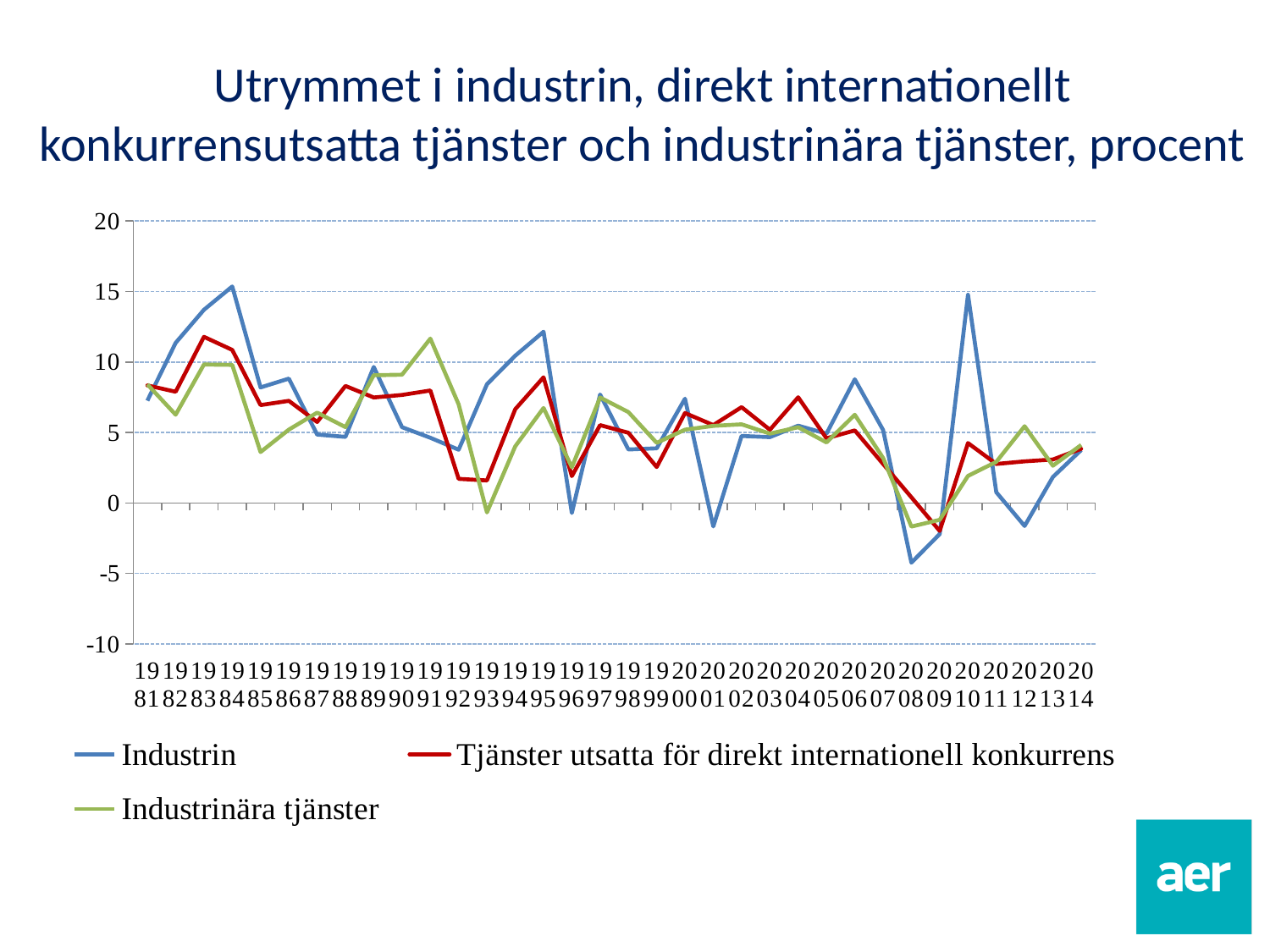
Is the value for Tjänster utsatta för direkt internationell konkurrens in 1992 greater or less than 5? less In 1984, which series has the larger value: Industrin or Tjänster utsatta för direkt internationell konkurrens? Industrin In which year does the Industrinära tjänster series reach its highest value? 1991 What kind of chart is shown on the slide? line chart How many series does the legend list? 3 Is the value for Industrin in 2008 greater or less than 0? less Does the Industrin series rise or fall from 1981 to 1984? rise How many years are plotted along the x axis? 34 Is the value for Industrin in 2001 greater or less than 0? less In which year does the Industrin series reach its lowest value? 2008